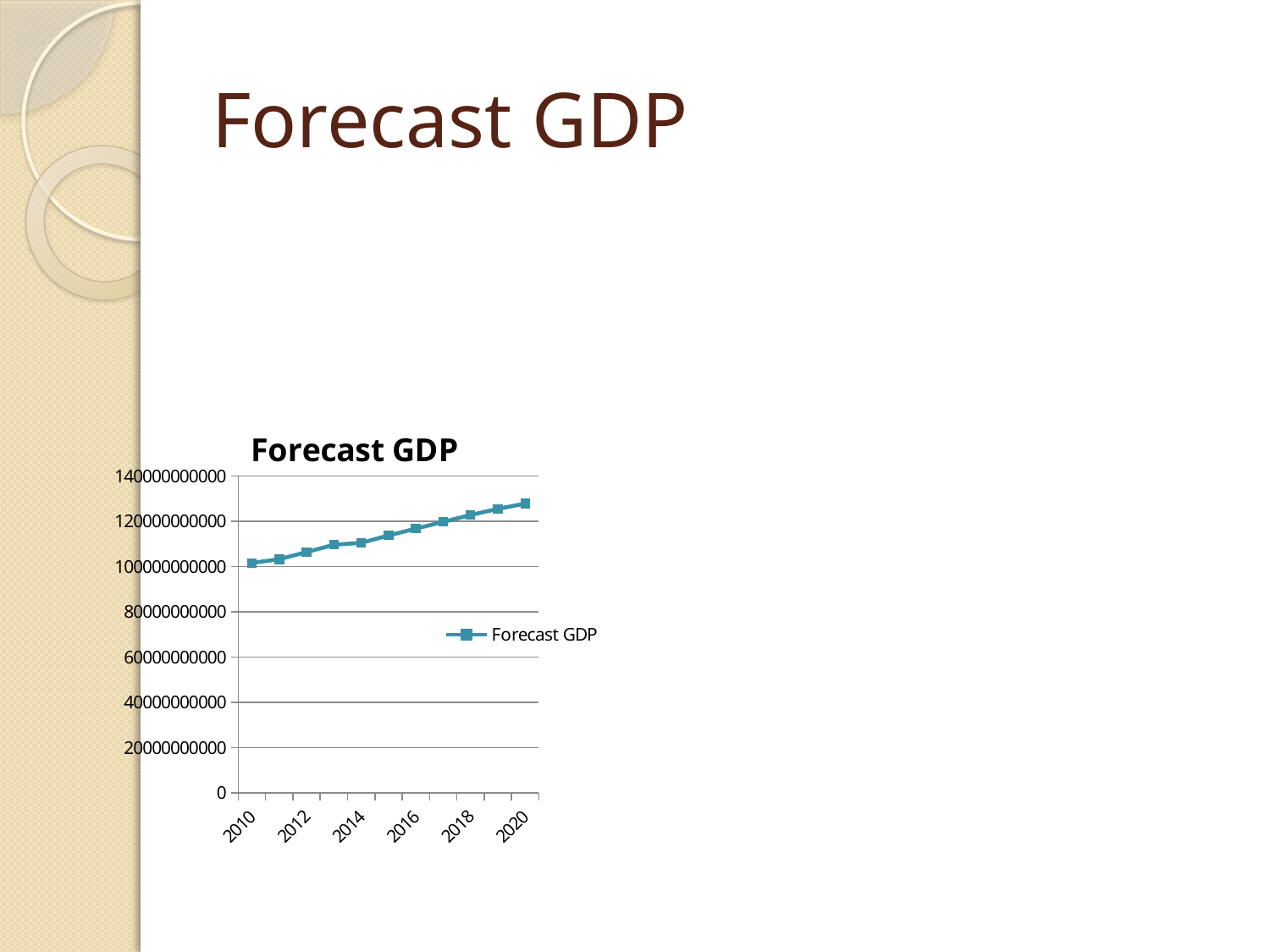
Is the Forecast GDP value for 2010 greater or less than 120000000000? less What kind of chart is shown on the slide? line chart Is the Forecast GDP value for 2020 greater or less than 140000000000? less Which year has the larger Forecast GDP value, 2012 or 2018? 2018 What is the name of the series shown in the legend? Forecast GDP Is the Forecast GDP value for 2020 greater or less than 120000000000? greater Do the Forecast GDP values rise or fall from 2010 to 2020? rise What is the title of the chart? Forecast GDP Which year has the lowest Forecast GDP value? 2010 How many data points are plotted on the line? 11 Which year has the highest Forecast GDP value? 2020 How many series does the legend list? 1